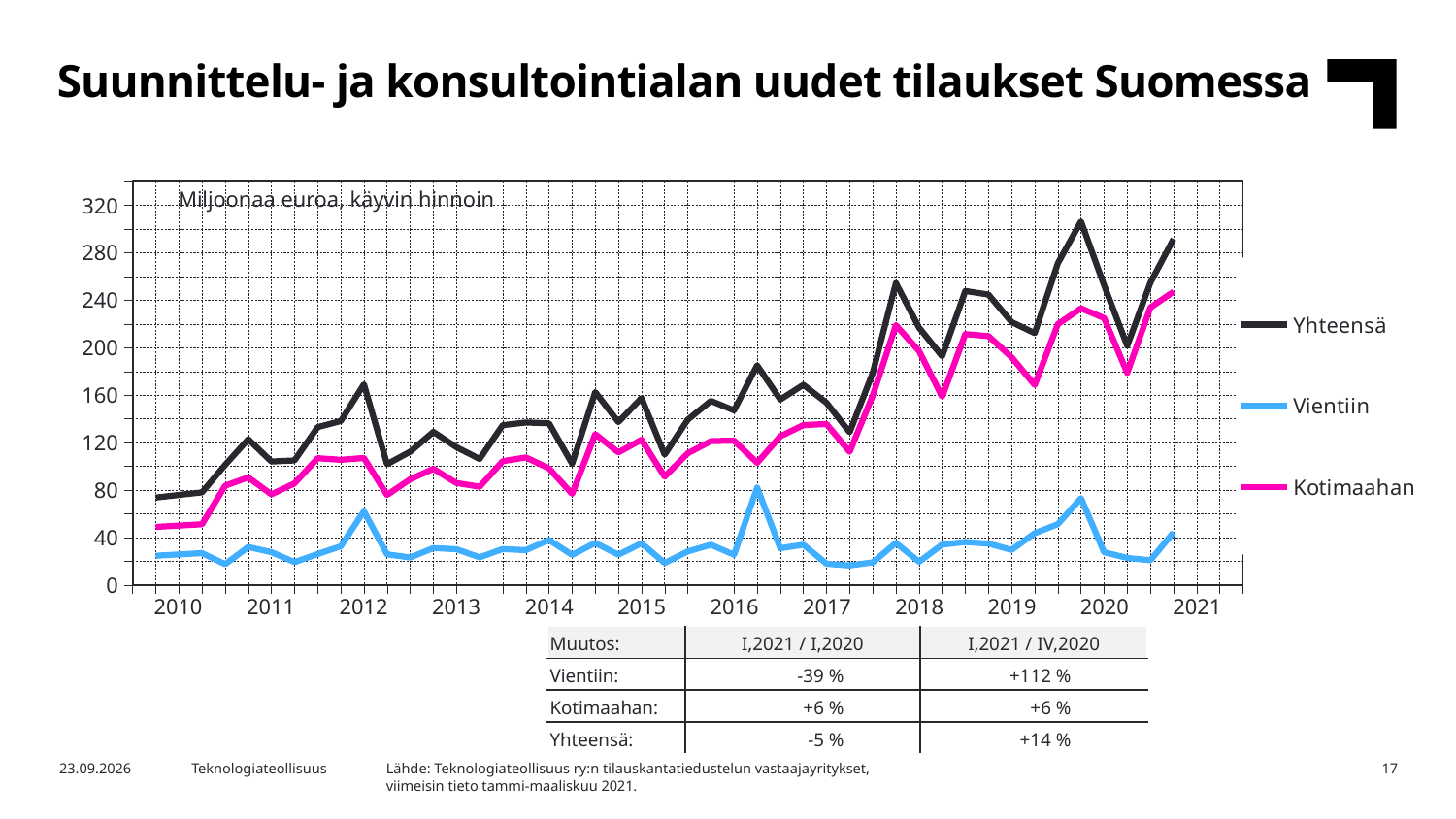
Is the value of the Kotimaahan line at the start of 2010 greater or less than 40? greater Is the peak value of the Yhteensä line (around late 2019) greater or less than 280? greater Is the value of the Vientiin line at the start of 2010 greater or less than 40? less Which series has the lowest values throughout the chart? Vientiin How many series does the chart legend list? 3 What unit label is printed inside the chart area? Miljoonaa euroa, käyvin hinnoin How many year labels are shown on the x axis? 12 Does the Yhteensä line overall rise or fall from 2010 to 2021? rise What are the three series named in the chart legend? Yhteensä, Vientiin, Kotimaahan What kind of chart is shown on the slide? line chart Which series has the highest values throughout the chart? Yhteensä At the last point in 2021, which is larger: Yhteensä or Vientiin? Yhteensä